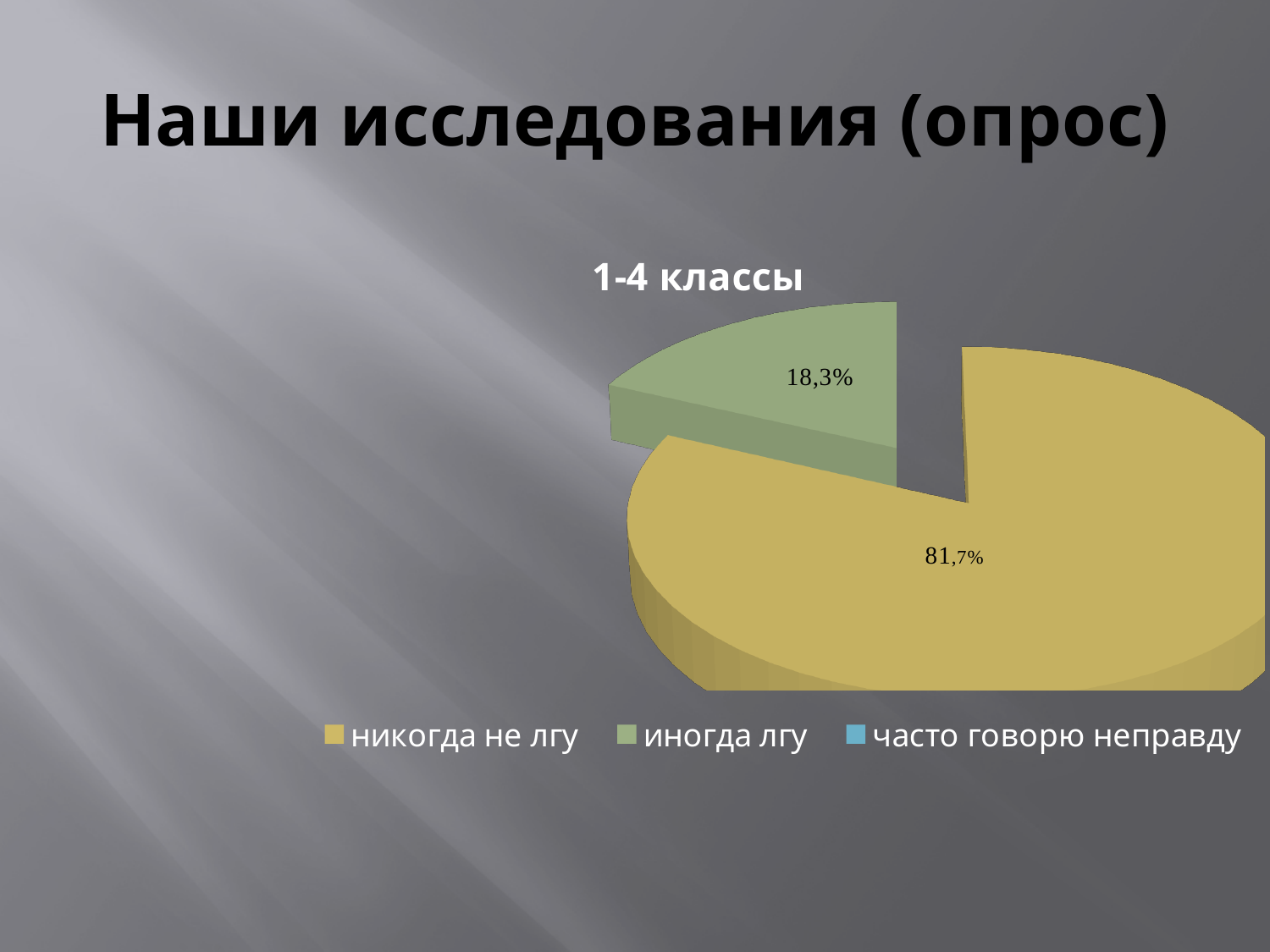
Which category has the largest slice of the pie? никогда не лгу What is the title of the chart? 1-4 классы How many entries does the legend list? 3 What share of the pie is labelled for "никогда не лгу"? 81,7% What is the difference in percentage points between the "никогда не лгу" slice and the "иногда лгу" slice? 63,4 How many slices are visibly drawn in the pie? 2 Which of the visible slices is the smallest? иногда лгу What kind of chart is shown on the slide? pie chart Which is larger, the slice for "никогда не лгу" or the slice for "иногда лгу"? никогда не лгу What share of the pie is labelled for "иногда лгу"? 18,3% What colour is the slice for "иногда лгу"? green